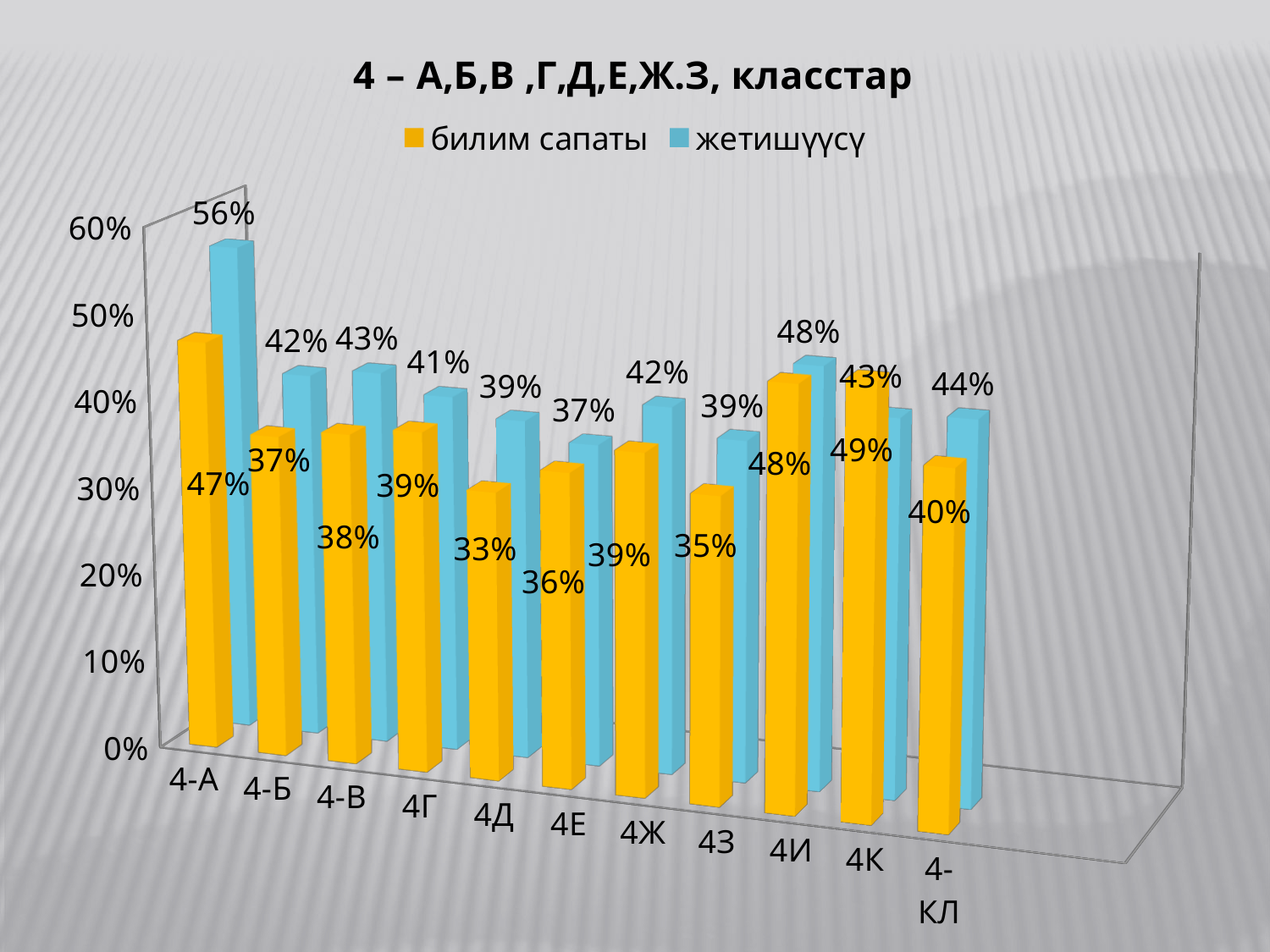
What is the value of билим сапаты for class 4К? 49% What type of chart is shown on the slide? bar chart Which series is shown in yellow in the legend? билим сапаты Which class has the lowest билим сапаты value? 4Д What is the value of жетишүүсү for class 4-КЛ? 44% What is the difference between жетишүүсү and билим сапаты for class 4-А? 9% What is the value of жетишүүсү for class 4-А? 56% What is the value of билим сапаты for class 4Д? 33% How many series does the legend list? 2 Which class has the highest жетишүүсү value? 4-А For class 4К, which is larger: билим сапаты or жетишүүсү? билим сапаты How many classes (categories) are shown on the x axis? 11